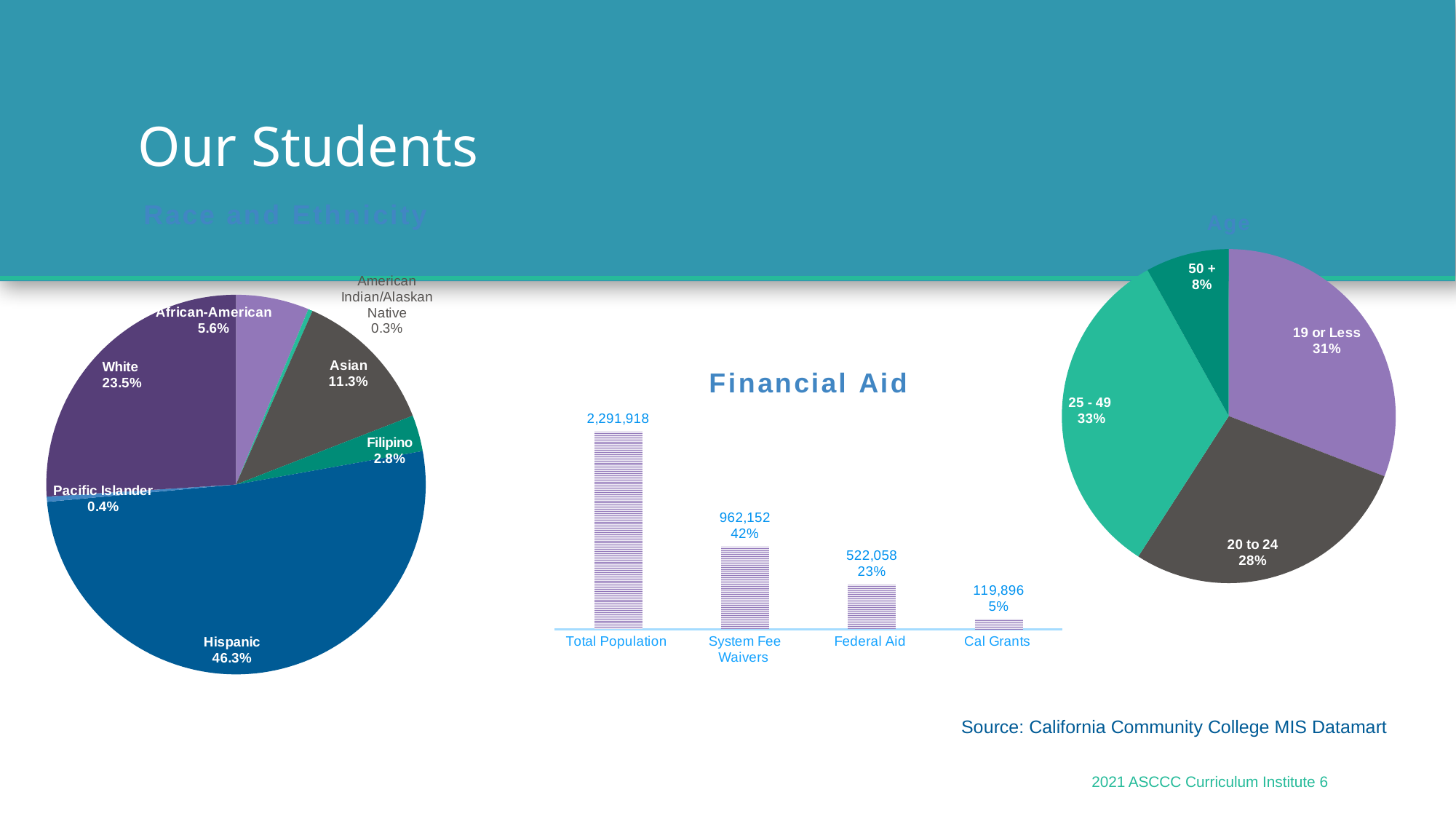
In the Financial Aid chart, is the value for System Fee Waivers larger or smaller than the value for Federal Aid? Larger In the Age pie chart on the right, what share is 25 - 49? 33% In the Financial Aid chart, which category has the lowest value? Cal Grants In the Race and Ethnicity pie chart on the left, which category has the smallest slice? American Indian/Alaskan Native In the Race and Ethnicity pie chart on the left, how many categories are shown? 7 What kind of chart is the Financial Aid chart? Bar chart In the Race and Ethnicity pie chart on the left, which category has the largest slice? Hispanic In the Financial Aid chart, what percentage is shown for Federal Aid? 23% In the Age pie chart on the right, which age group has the smallest share? 50 + In the Race and Ethnicity pie chart on the left, what share is Hispanic? 46.3% In the Race and Ethnicity pie chart on the left, what is the difference between the White and Asian shares? 12.2% In the Financial Aid chart, what is the value for Total Population? 2,291,918